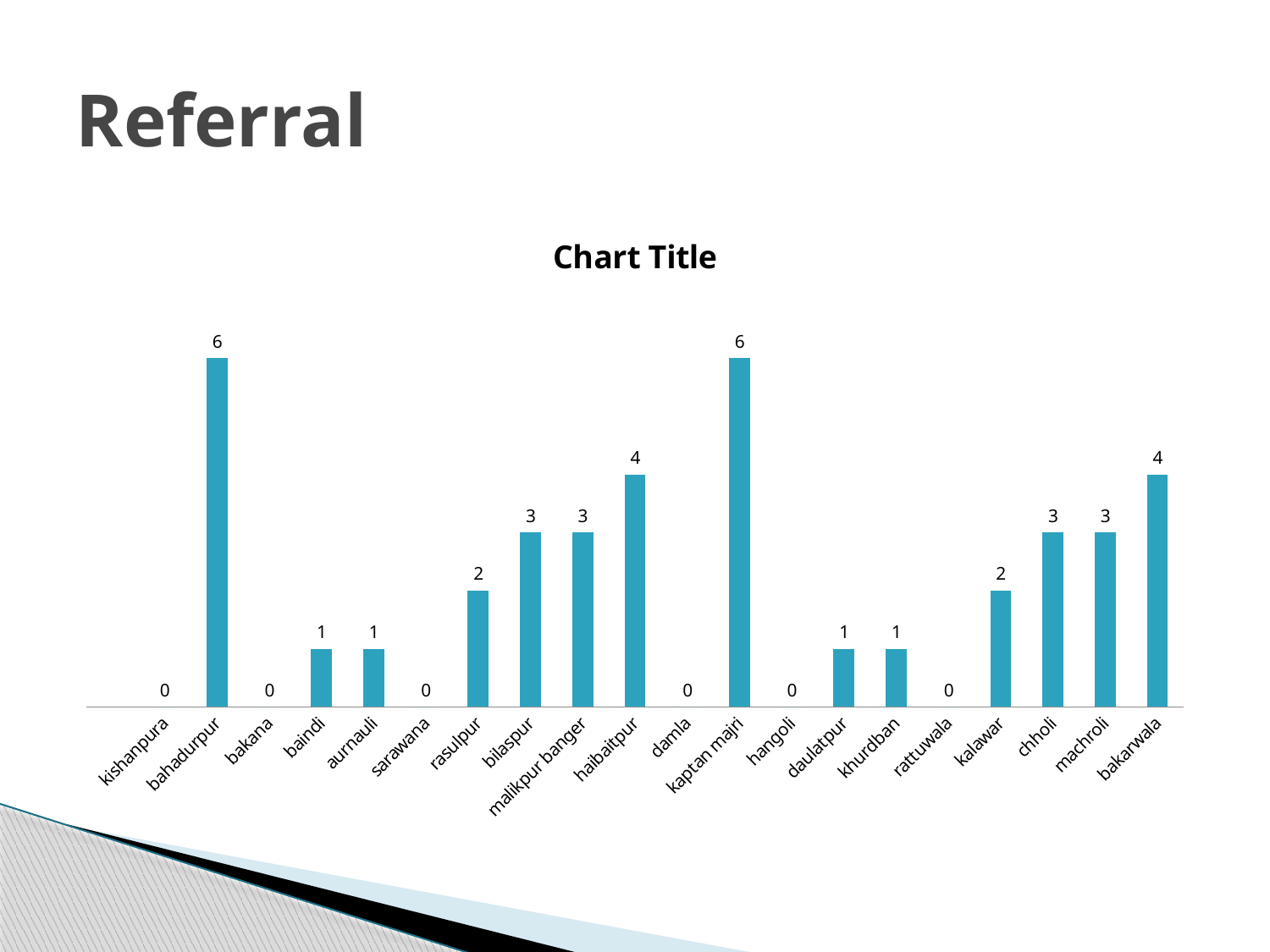
How many categories are shown on the x axis of the chart? 20 Which has a larger value, bahadurpur or haibaitpur? bahadurpur Which has a larger value, kalawar or machroli? machroli What is the value for chholi? 3 What is the value for bahadurpur? 6 What is the highest value shown in the chart? 6 What is the difference between the values for bilaspur and baindi? 2 What is the value for haibaitpur? 4 What is the value for rasulpur? 2 What is the difference between the values for kaptan majri and bakarwala? 2 What is the value for kishanpura? 0 What kind of chart is shown on the slide? bar chart